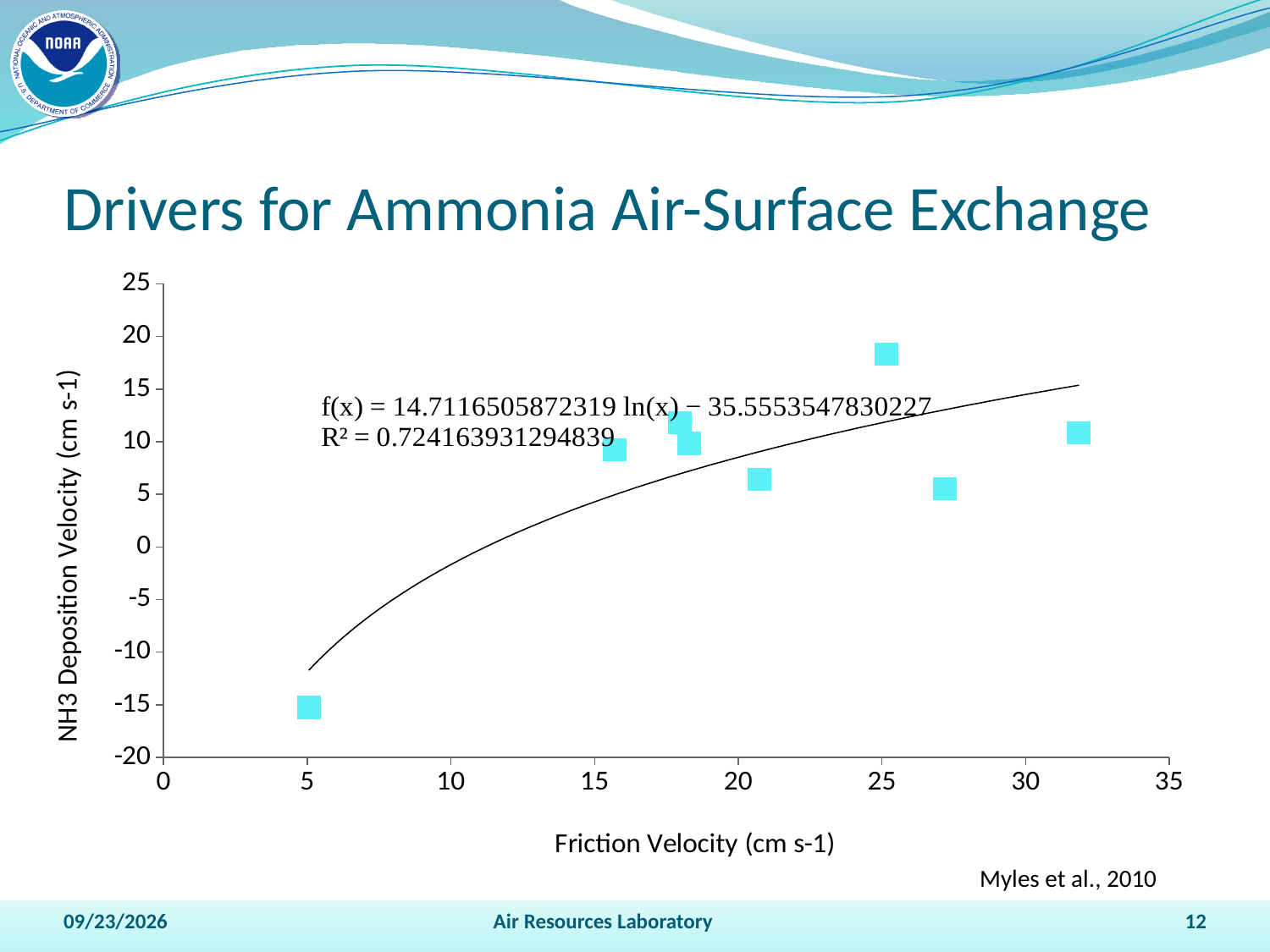
What kind of chart is shown on the slide? Scatter chart What is the equation of the trendline printed on the chart? f(x) = 14.7116505872319 ln(x) − 35.5553547830227 Is the friction velocity of the point with the lowest NH3 deposition velocity greater or less than 10? less Which has the larger NH3 deposition velocity: the point at a friction velocity of about 25 or the point at a friction velocity of about 5? The point at about 25 Is the lowest NH3 deposition velocity plotted on the chart greater or less than -10? less How many data points are plotted on the chart? 8 What is the title of the chart's y axis? NH3 Deposition Velocity (cm s-1) What R² value is printed on the chart for the fitted trendline? 0.724163931294839 Is the highest NH3 deposition velocity plotted on the chart greater or less than 15? greater What is the title of the chart's x axis? Friction Velocity (cm s-1) Does the fitted trendline rise or fall as friction velocity increases? Rises